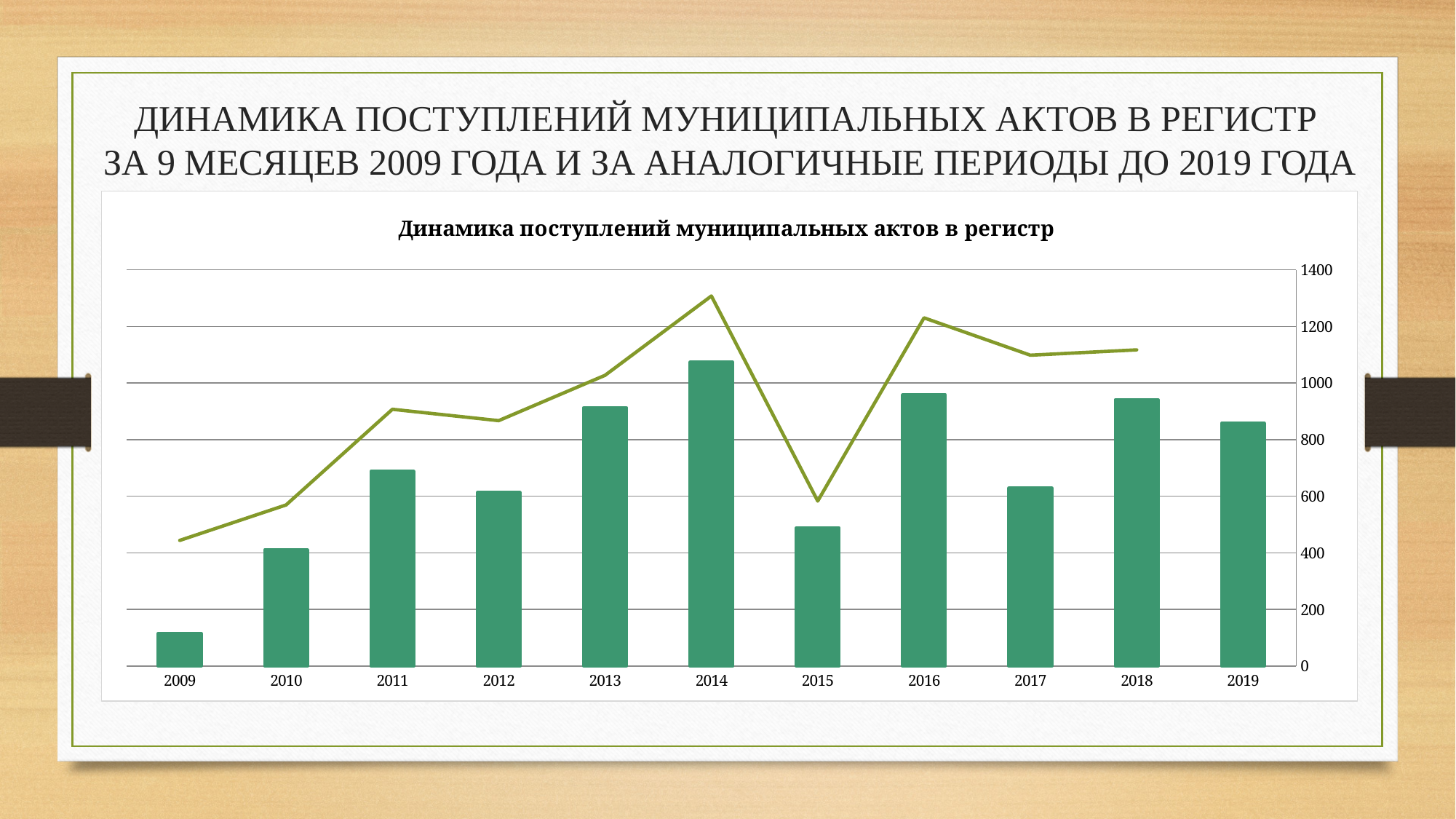
Is the bar value for 2014 greater or less than 1000? greater Is the bar value for 2015 greater or less than 600? less How many years are shown on the x axis of the chart? 11 Do the bar values rise or fall from 2014 to 2015? fall Which year has the shortest bar in the chart? 2009 What kind of chart is shown on the slide? A bar chart combined with a line Which year has the tallest bar in the chart? 2014 What is the title printed above the chart? Динамика поступлений муниципальных актов в регистр Which bar is taller, 2013 or 2017? 2013 Is the bar value for 2018 greater or less than 800? greater Which bar is taller, 2010 or 2011? 2011